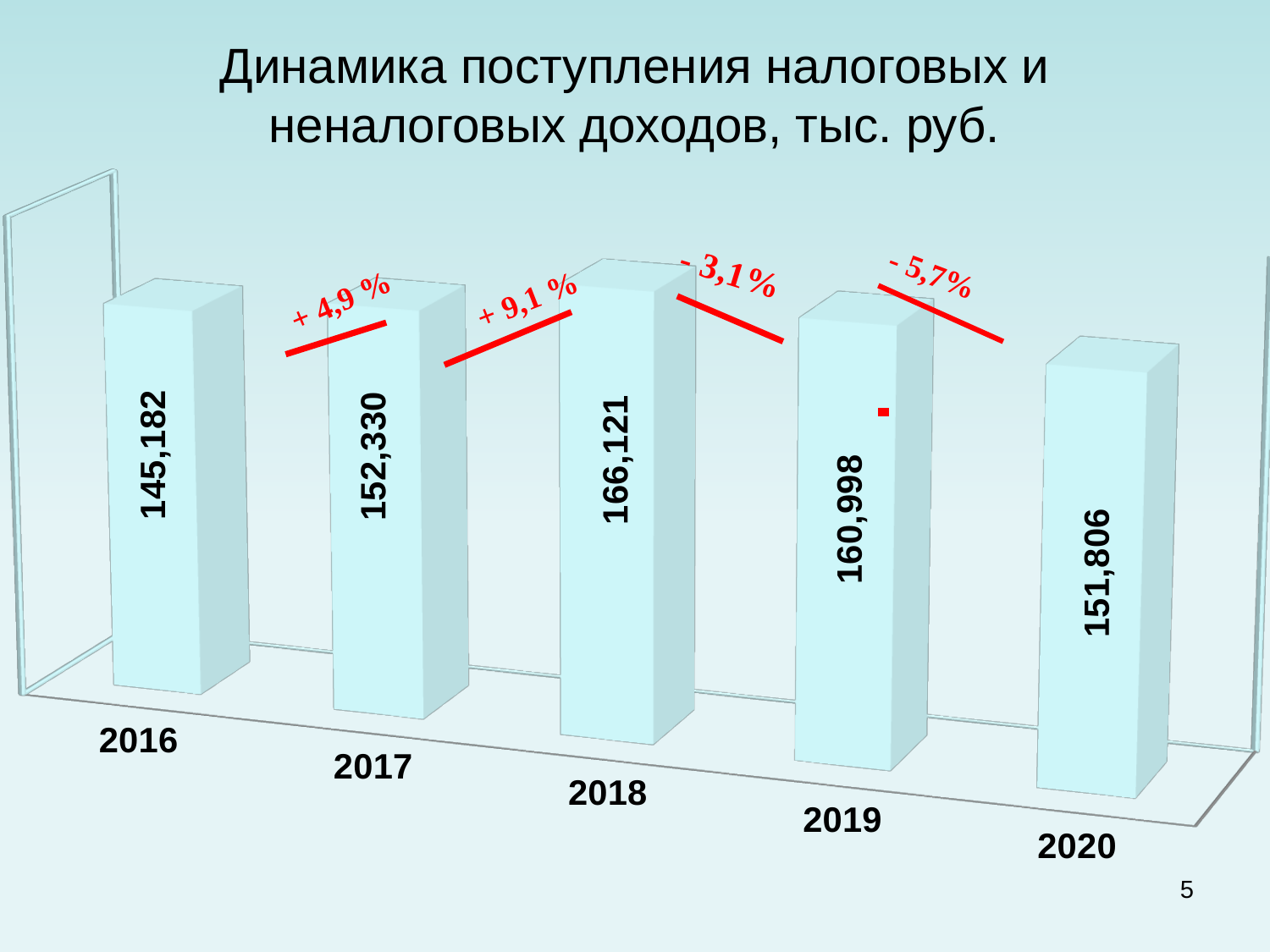
Which year has the lowest value? 2016 Which year has the highest value? 2018 What kind of chart is this? bar chart What percentage change is annotated between 2019 and 2020? - 5,7% What is the value for 2016? 145,182 How many years are shown on the chart? 5 Which is larger, the value for 2017 or the value for 2019? 2019 What is the difference between the values for 2019 and 2020? 9,192 What is the value for 2020? 151,806 What percentage change is annotated between 2017 and 2018? + 9,1 % What is the difference between the values for 2018 and 2017? 13,791 What is the value for 2018? 166,121